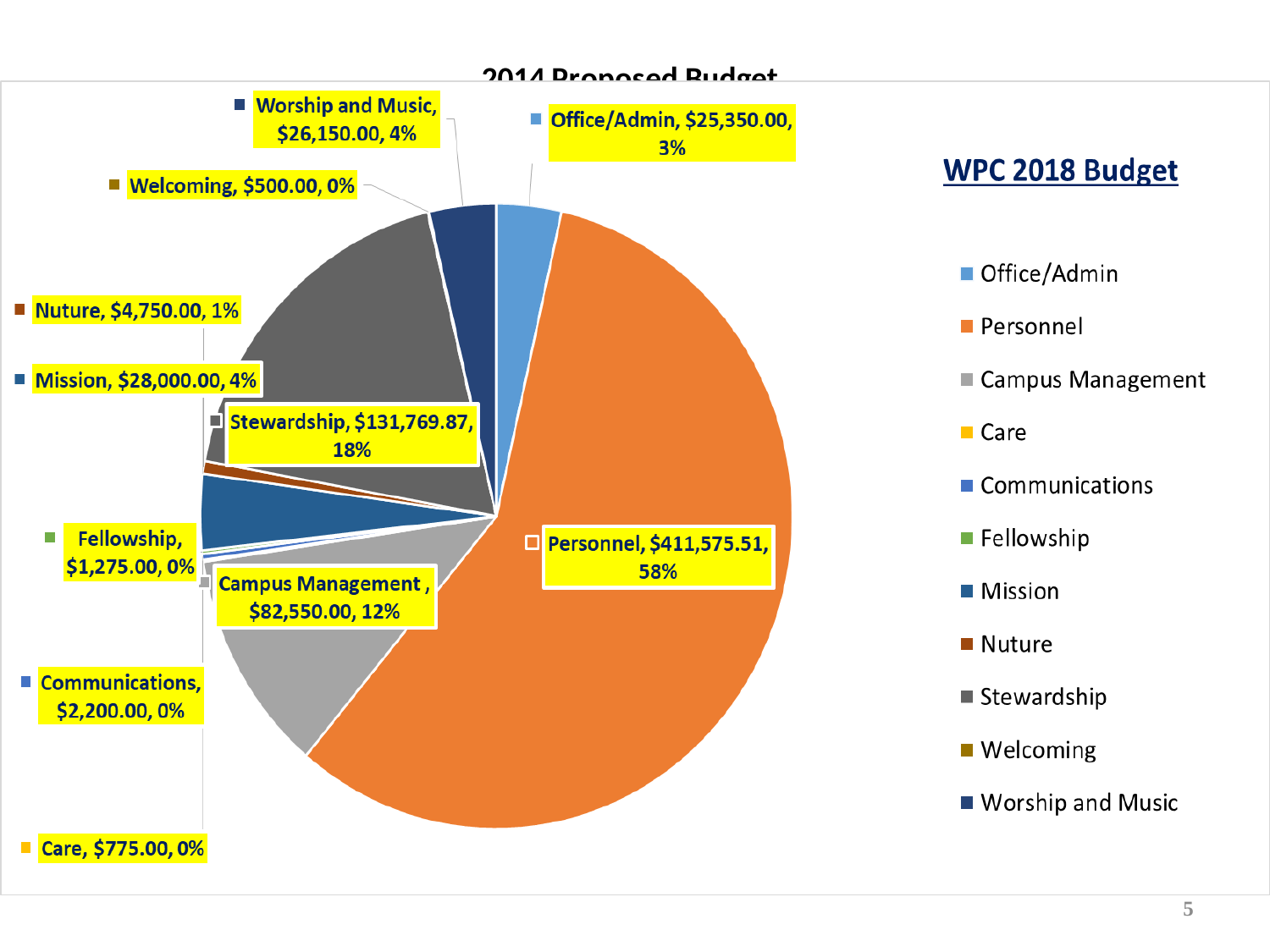
What is the value for Personnel? $411,575.51 What percentage share does Personnel have? 58% Which category has the smallest value? Welcoming What is the value for Nuture? $4,750.00 What is the difference between the Mission value and the Worship and Music value? $1,850.00 What is the value for Stewardship? $131,769.87 What kind of chart is shown on the slide? pie chart What colour is the Personnel slice? orange Which category has the largest slice? Personnel Which is larger, the value for Office/Admin or the value for Mission? Mission How many categories does the legend list? 11 What percentage share does Campus Management have? 12%